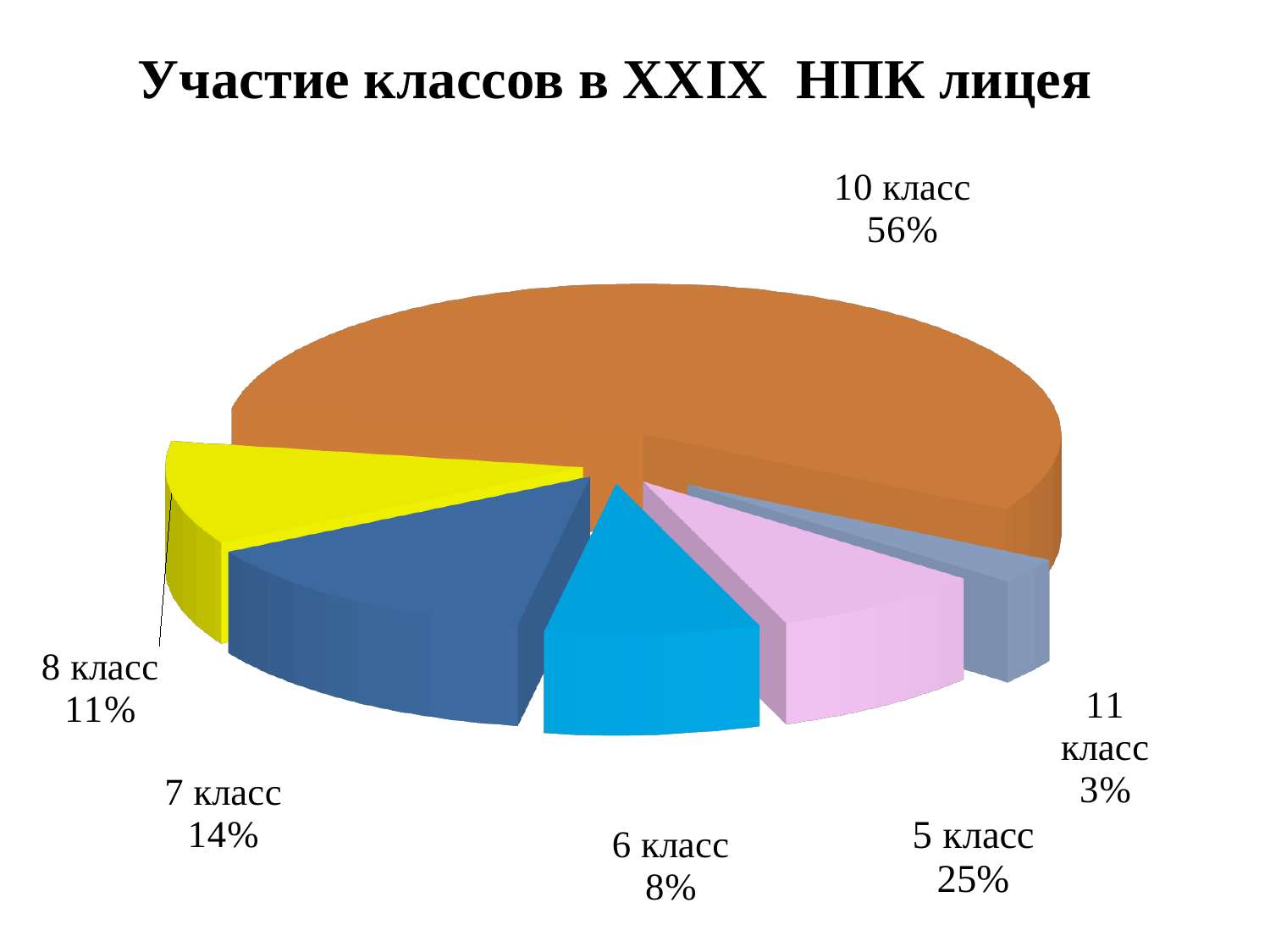
Which is larger, the share for 8 класс or the share for 6 класс? 8 класс What colour is the slice for 10 класс? orange-brown What is the difference in percentage points between 10 класс and 5 класс? 31 What percentage is shown for 10 класс? 56% Which class has the largest slice of the pie? 10 класс What percentage is shown for 5 класс? 25% What percentage is shown for 7 класс? 14% What kind of chart is shown on the slide? pie chart Which class has the smallest slice of the pie? 11 класс What percentage is shown for 11 класс? 3% How many slices does the pie chart have? 6 What is the title of the chart? Участие классов в XXIX НПК лицея